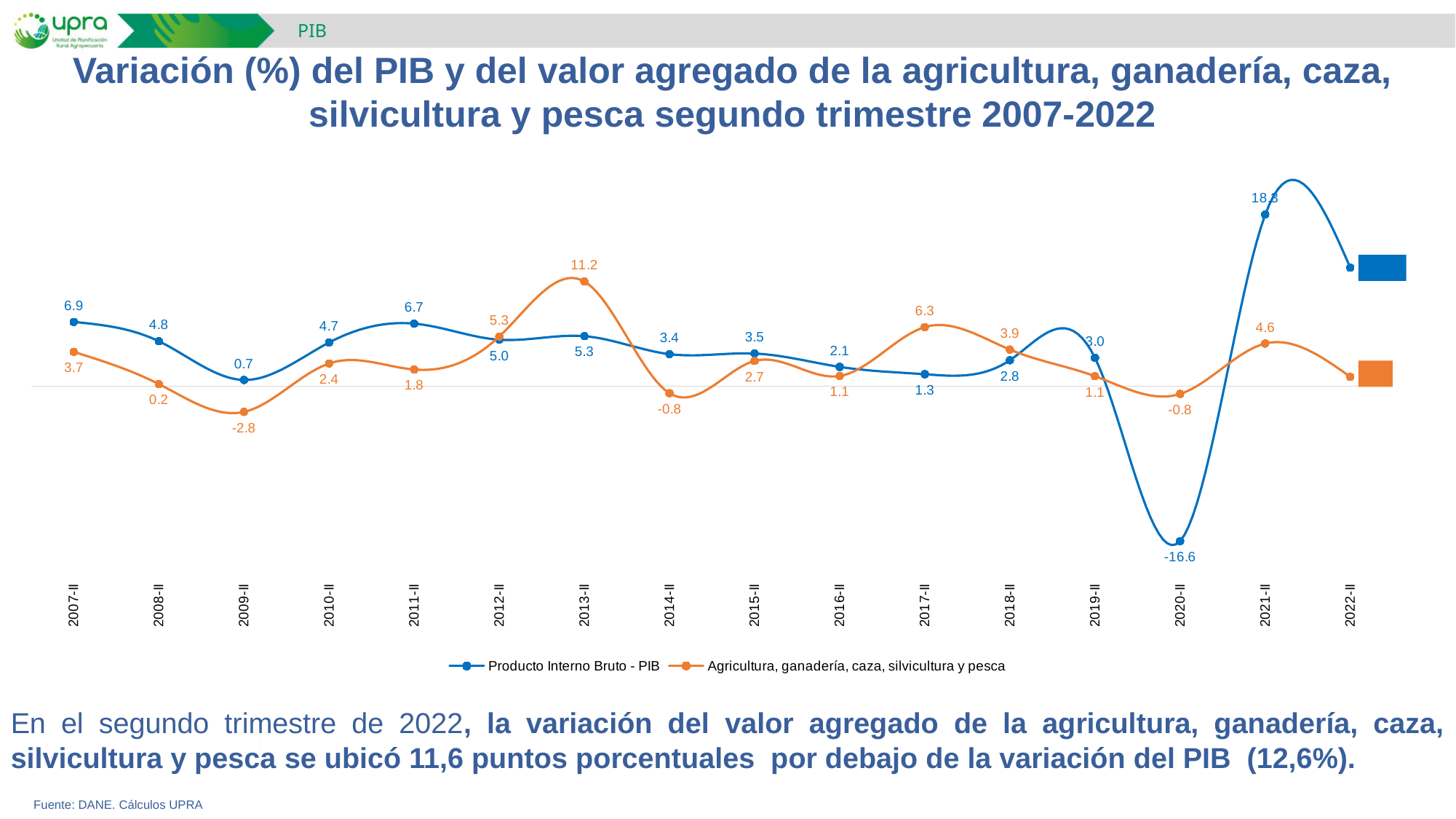
How many periods are shown on the x axis? 16 How many series does the legend list? 2 What is the difference between the Agricultura, ganadería, caza, silvicultura y pesca value and the PIB value in 2013-II? 5.9 In 2017-II, which series has the larger value: Producto Interno Bruto - PIB or Agricultura, ganadería, caza, silvicultura y pesca? Agricultura, ganadería, caza, silvicultura y pesca What is the value for Agricultura, ganadería, caza, silvicultura y pesca in 2009-II? -2.8 What is the value for Agricultura, ganadería, caza, silvicultura y pesca in 2013-II? 11.2 What type of chart is shown on the slide? Line chart In which period is the Agricultura, ganadería, caza, silvicultura y pesca value highest? 2013-II What colour is the line for Producto Interno Bruto - PIB? Blue In which period is the Producto Interno Bruto - PIB value lowest? 2020-II What is the value for Producto Interno Bruto - PIB in 2020-II? -16.6 What is the value for Producto Interno Bruto - PIB in 2009-II? 0.7